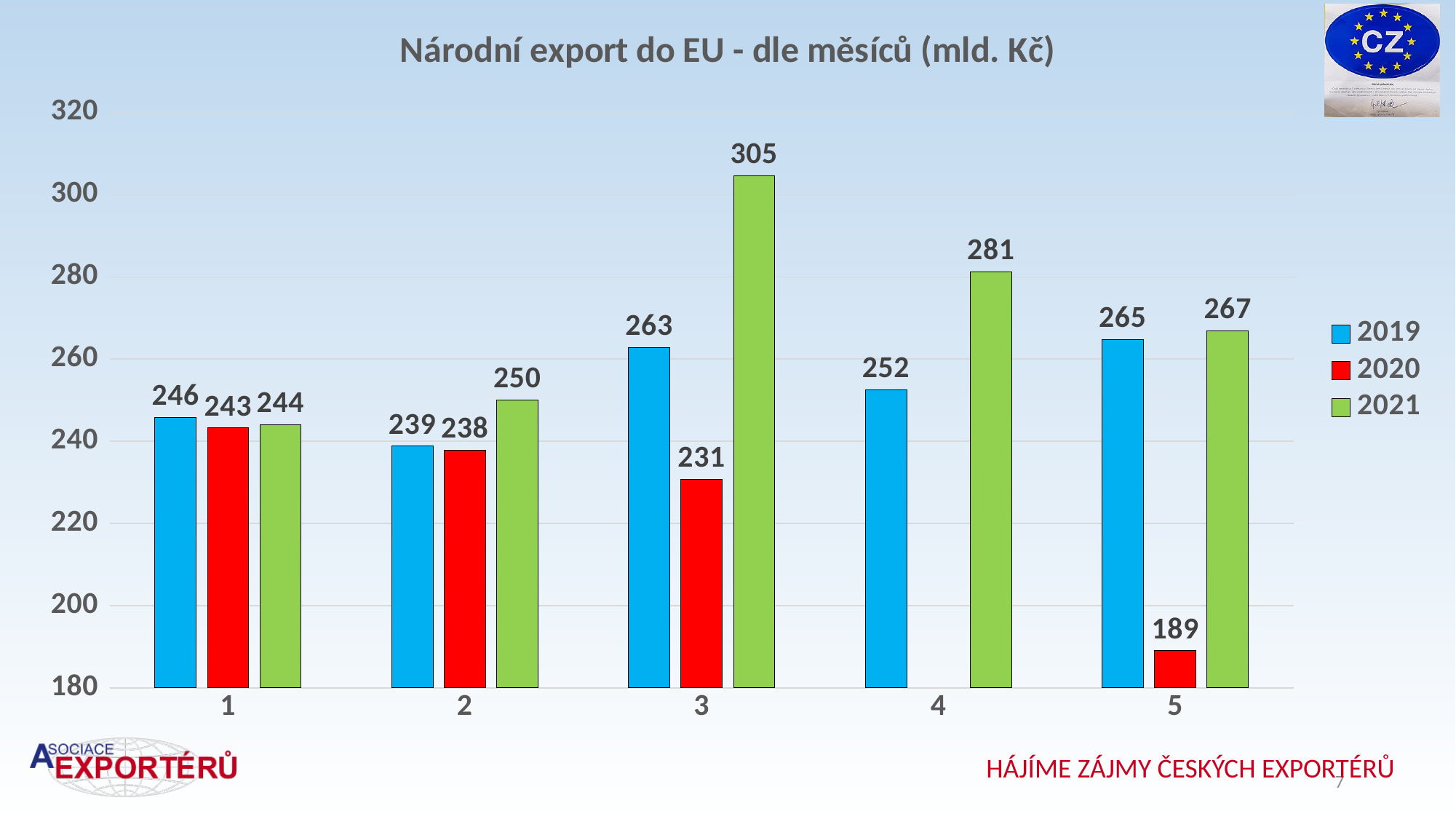
What is the difference between the 2021 and 2019 values in month 3? 42 How many months are shown on the x axis? 5 What kind of chart is shown on the slide? bar chart Is the value for 2021 in month 4 greater or less than 260? greater What is the value for 2021 in month 3? 305 What colour represents the 2020 series in the legend? red How many series does the legend list? 3 Which month has the highest value for the 2021 series? 3 What is the value for 2019 in month 4? 252 Which is larger in month 2: the 2019 value or the 2021 value? 2021 What is the value for 2020 in month 5? 189